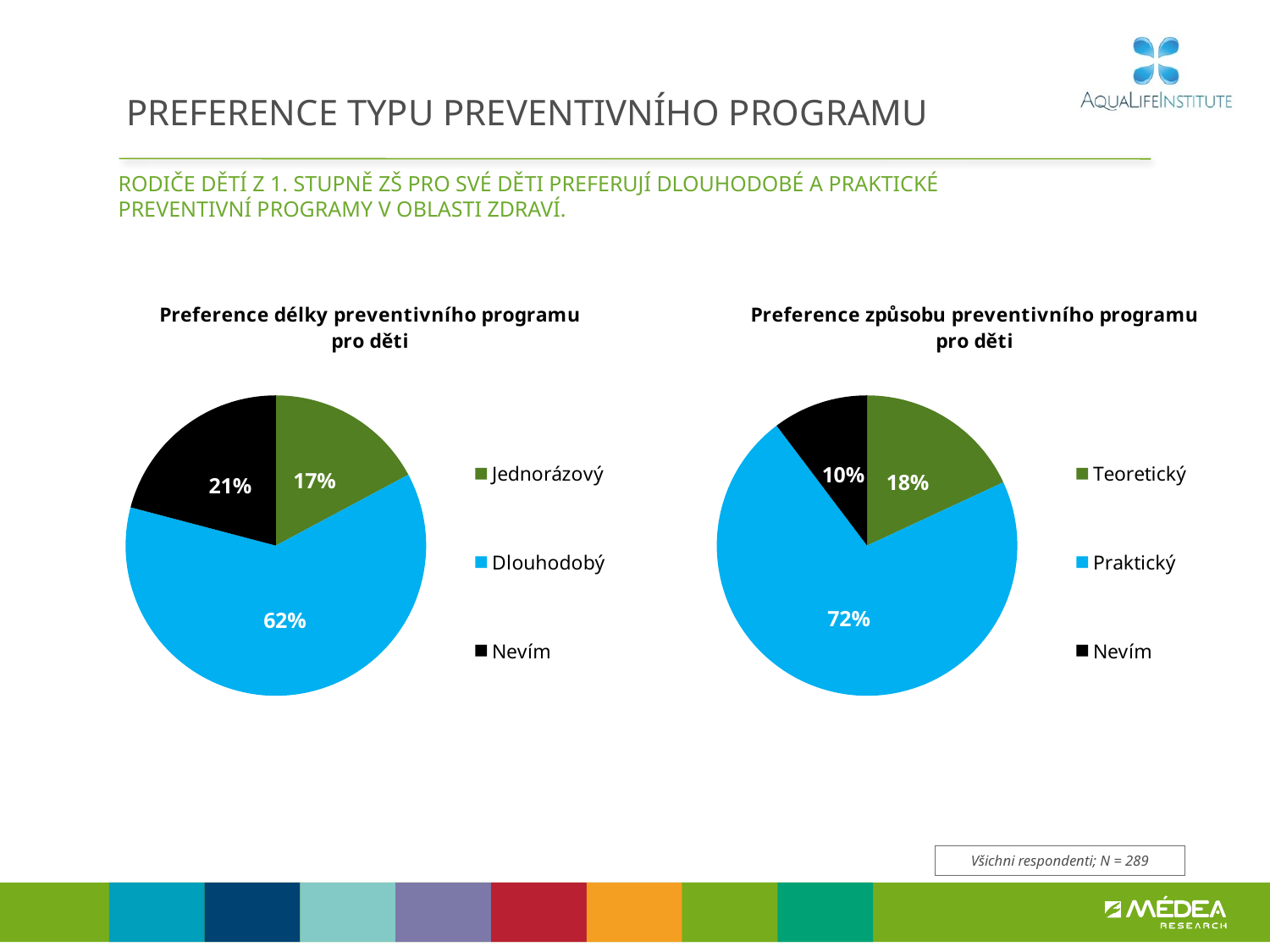
In the left chart 'Preference délky preventivního programu pro děti', what share is Jednorázový? 17% In the right chart 'Preference způsobu preventivního programu pro děti', which category has the smallest share? Nevím In the left chart 'Preference délky preventivního programu pro děti', what share is Dlouhodobý? 62% In the right chart 'Preference způsobu preventivního programu pro děti', what share is Teoretický? 18% What type of chart is the right chart 'Preference způsobu preventivního programu pro děti'? Pie chart In the right chart 'Preference způsobu preventivního programu pro děti', which is larger: Teoretický or Nevím? Teoretický In the right chart 'Preference způsobu preventivního programu pro děti', what share is Praktický? 72% In the left chart 'Preference délky preventivního programu pro děti', what share is Nevím? 21% In the right chart 'Preference způsobu preventivního programu pro děti', what share is Nevím? 10% In the left chart 'Preference délky preventivního programu pro děti', what is the difference in percentage points between Dlouhodobý and Nevím? 41 percentage points In the left chart 'Preference délky preventivního programu pro děti', which category has the largest share? Dlouhodobý How many categories does the legend of the left chart 'Preference délky preventivního programu pro děti' list? 3